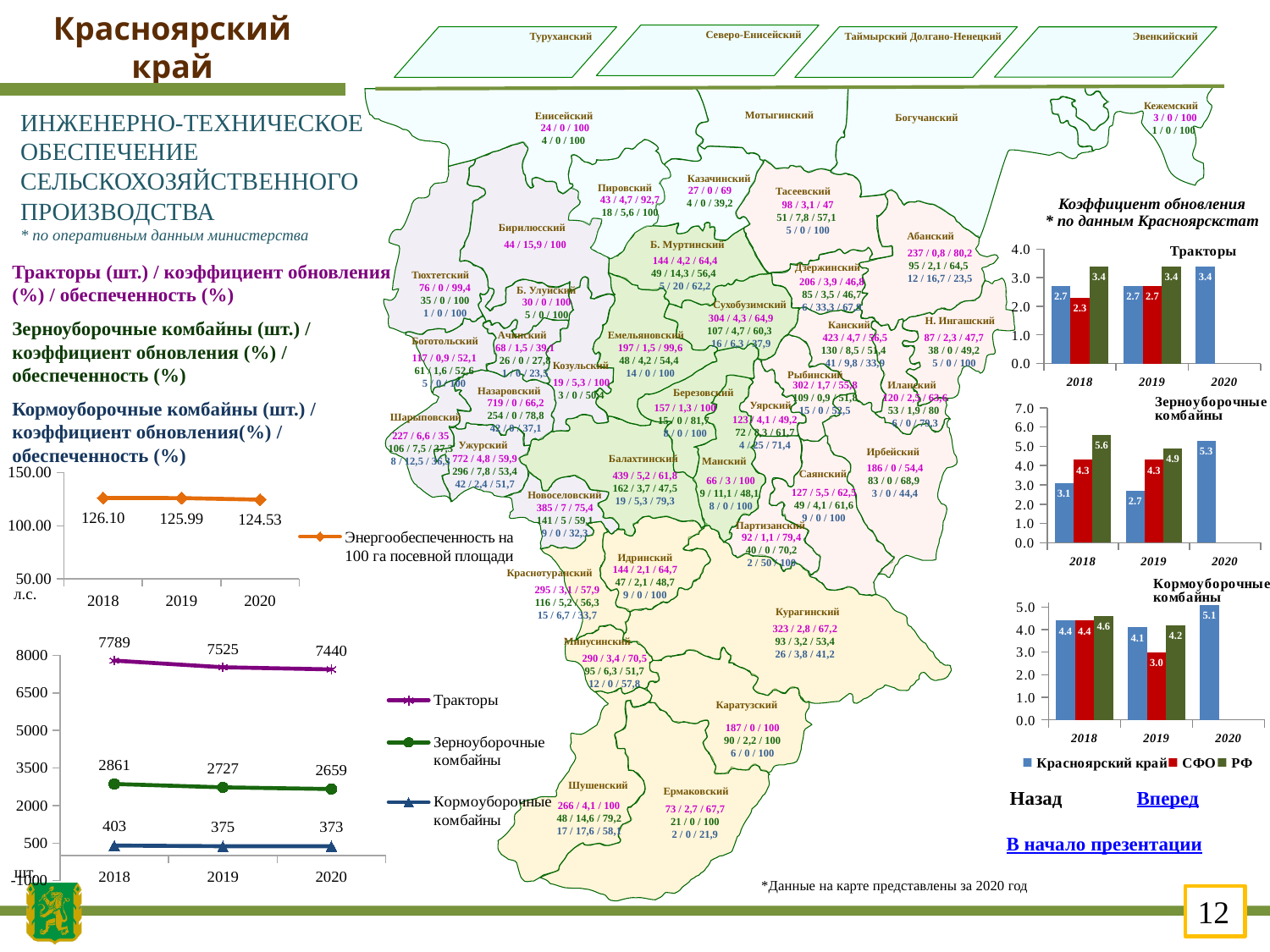
On the lower-left line chart of machinery counts, what is the difference between the Зерноуборочные комбайны values for 2018 and 2020? 202 What kind of chart is used for 'Коэффициент обновления' on the right side of the slide? bar chart On the 'Зерноуборочные комбайны' bar chart under 'Коэффициент обновления', which series has the highest value in 2018? РФ On the lower-left line chart of machinery counts, which series has the lowest values? Кормоуборочные комбайны On the lower-left line chart of machinery counts, what is the value for Тракторы in 2020? 7440 On the 'Зерноуборочные комбайны' bar chart under 'Коэффициент обновления', what is the difference between РФ and Красноярский край in 2019? 2.2 On the lower-left line chart of machinery counts, how many series does the legend list? 3 On the 'Кормоуборочные комбайны' bar chart under 'Коэффициент обновления', what is the value for Красноярский край in 2020? 5.1 On the line chart 'Энергообеспеченность на 100 га посевной площади', what is the value for 2018? 126.10 On the 'Кормоуборочные комбайны' bar chart under 'Коэффициент обновления', which is larger in 2019: Красноярский край or СФО? Красноярский край On the 'Тракторы' bar chart under 'Коэффициент обновления', what is the value for СФО in 2018? 2.3 On the line chart 'Энергообеспеченность на 100 га посевной площади', do the values rise or fall from 2018 to 2020? fall